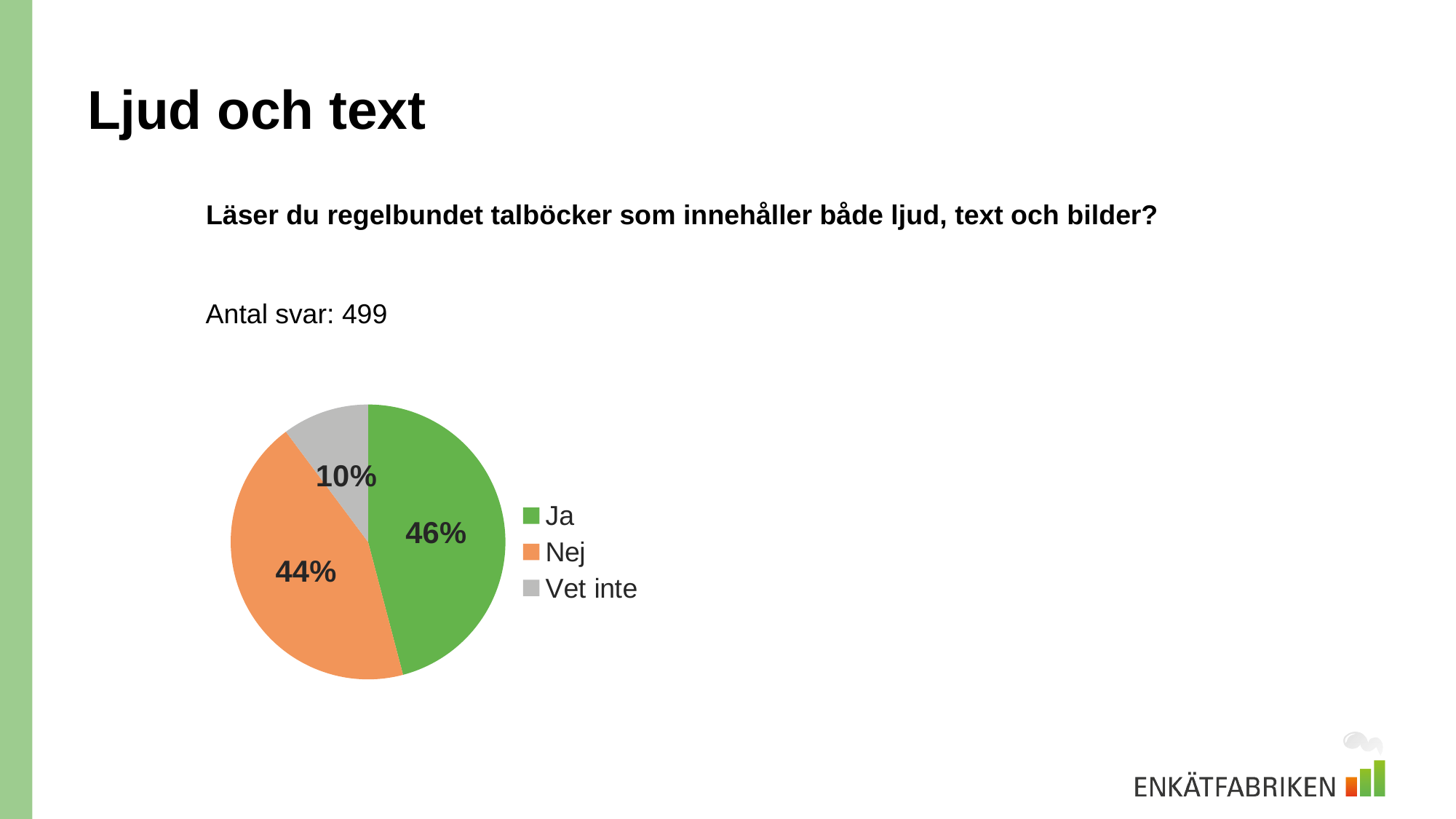
What colour is the "Nej" slice in the pie chart? Orange What percentage of respondents answered "Ja" in the pie chart? 46% Which slice is larger, "Nej" or "Vet inte"? Nej What share of the pie chart is labelled "Vet inte"? 10% What type of chart is shown on the slide? Pie chart What is the difference in percentage points between the "Ja" and "Nej" slices? 2 percentage points How many responses (Antal svar) does the slide report for this question? 499 How many entries does the chart legend list? 3 Which response has the largest share of the pie chart? Ja Which response has the smallest share of the pie chart? Vet inte What percentage of respondents answered "Nej" in the pie chart? 44% How many slices does the pie chart have? 3